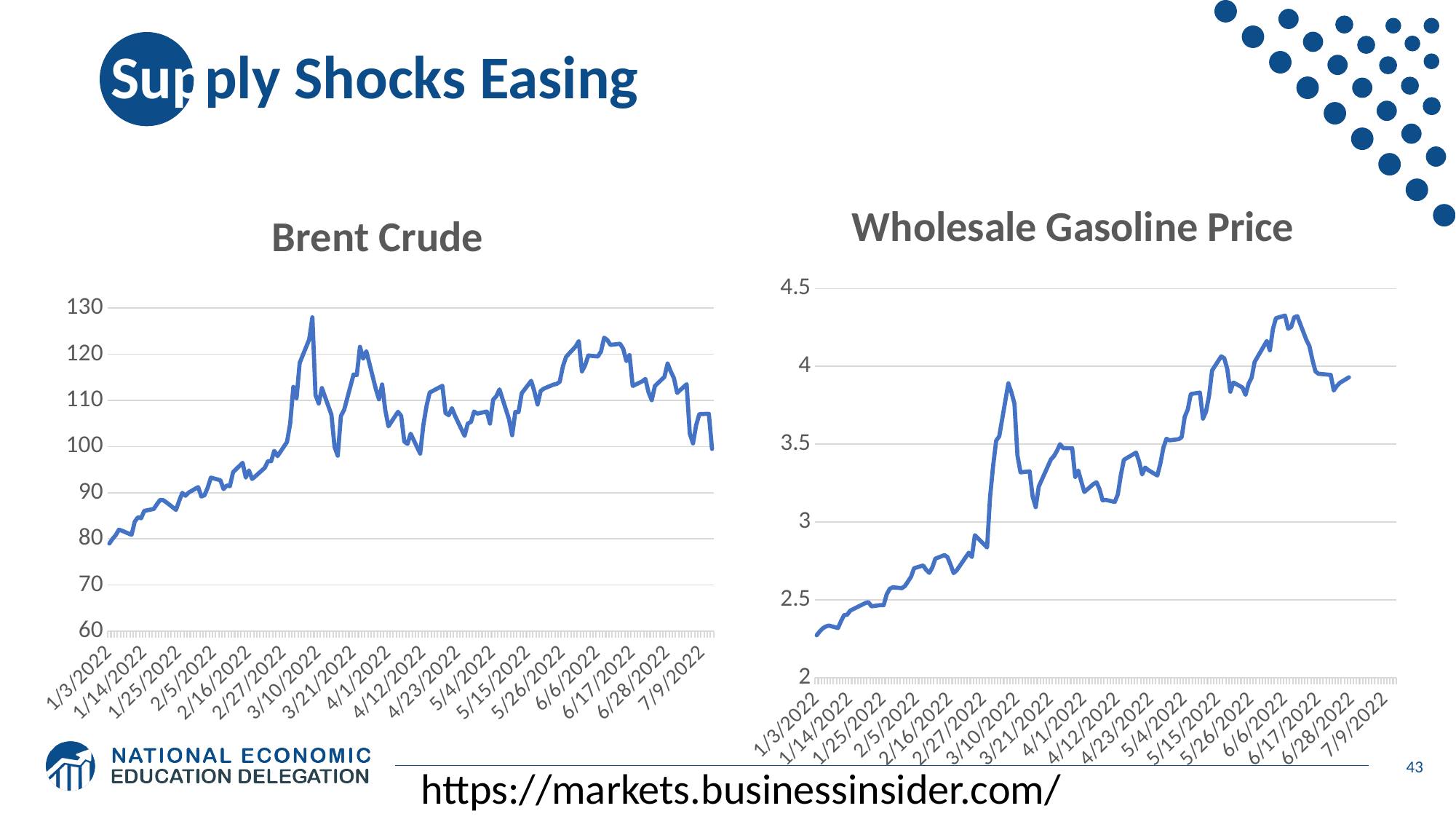
In the Brent Crude chart, is the peak value around 3/10/2022 greater or less than 120? greater In the Brent Crude chart, is the value on 1/3/2022 greater or less than 90? less In the Wholesale Gasoline Price chart, does the value rise or fall overall between 1/3/2022 and 6/6/2022? rise In the Brent Crude chart, does the value rise or fall between 1/3/2022 and 3/10/2022? rise In the Brent Crude chart, does the value rise or fall between 6/6/2022 and 7/9/2022? fall What kind of chart is the Wholesale Gasoline Price chart? line chart What is the title of the chart on the right side of the slide? Wholesale Gasoline Price In the Wholesale Gasoline Price chart, is the value on 1/3/2022 greater or less than 2.5? less What kind of chart is the Brent Crude chart? line chart